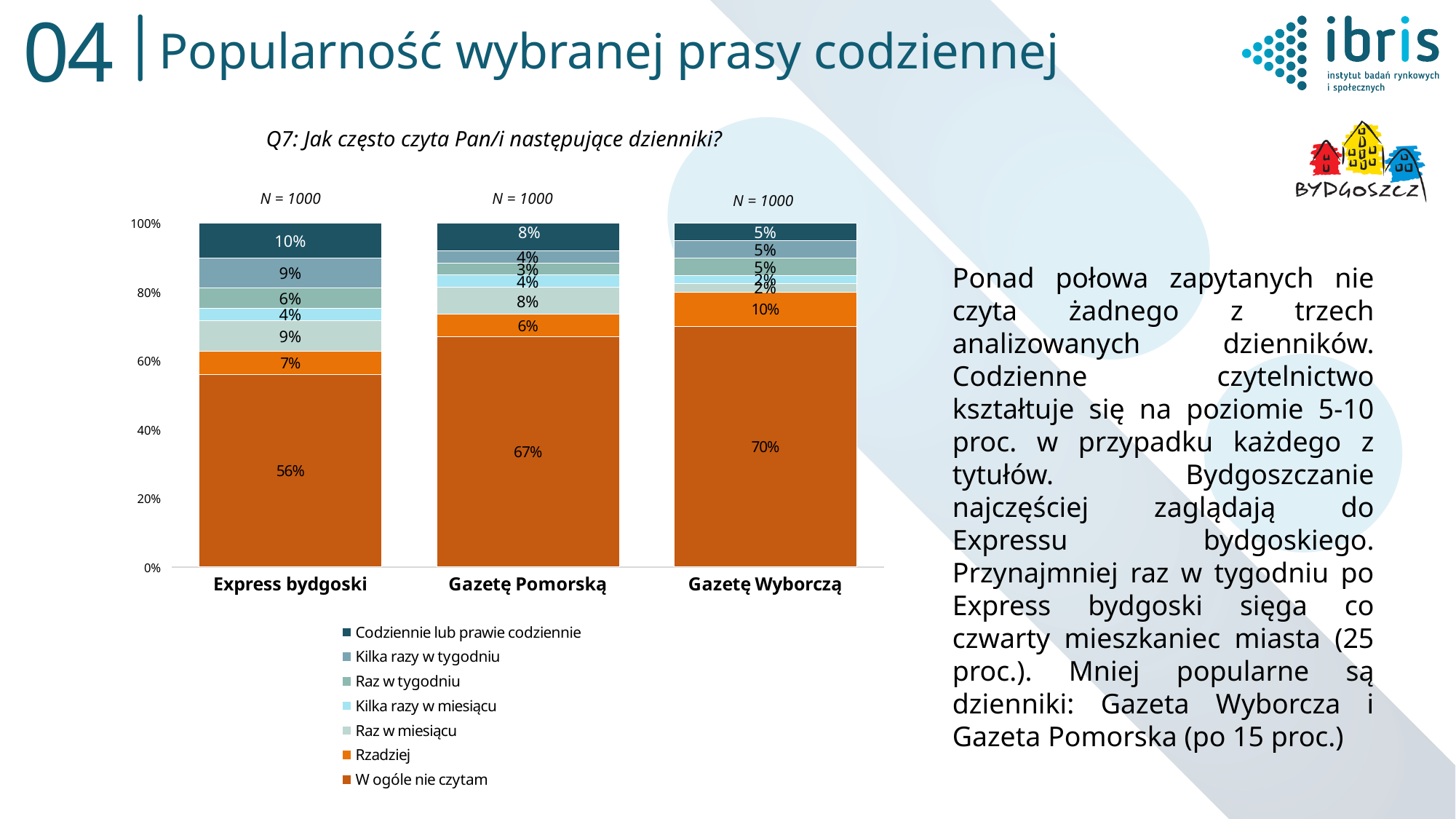
What kind of chart is shown on the slide? Stacked bar chart Which is larger: the 'Raz w miesiącu' value for Express bydgoski or for Gazetę Pomorską? Express bydgoski What is the 'Kilka razy w tygodniu' value for Express bydgoski? 9% What is the 'Codziennie lub prawie codziennie' value for Gazetę Pomorską? 8% How many newspapers are shown on the x axis? 3 What is the 'Rzadziej' value for Gazetę Wyborczą? 10% What sample size (N) is shown above each bar? N = 1000 Which newspaper has the highest share of 'W ogóle nie czytam'? Gazetę Wyborczą What is the difference between the 'W ogóle nie czytam' values for Gazetę Wyborczą and Express bydgoski? 14 percentage points How many series does the legend list? 7 What percentage of respondents say they do not read Express bydgoski at all (W ogóle nie czytam)? 56% Which newspaper has the lowest share of 'Codziennie lub prawie codziennie'? Gazetę Wyborczą